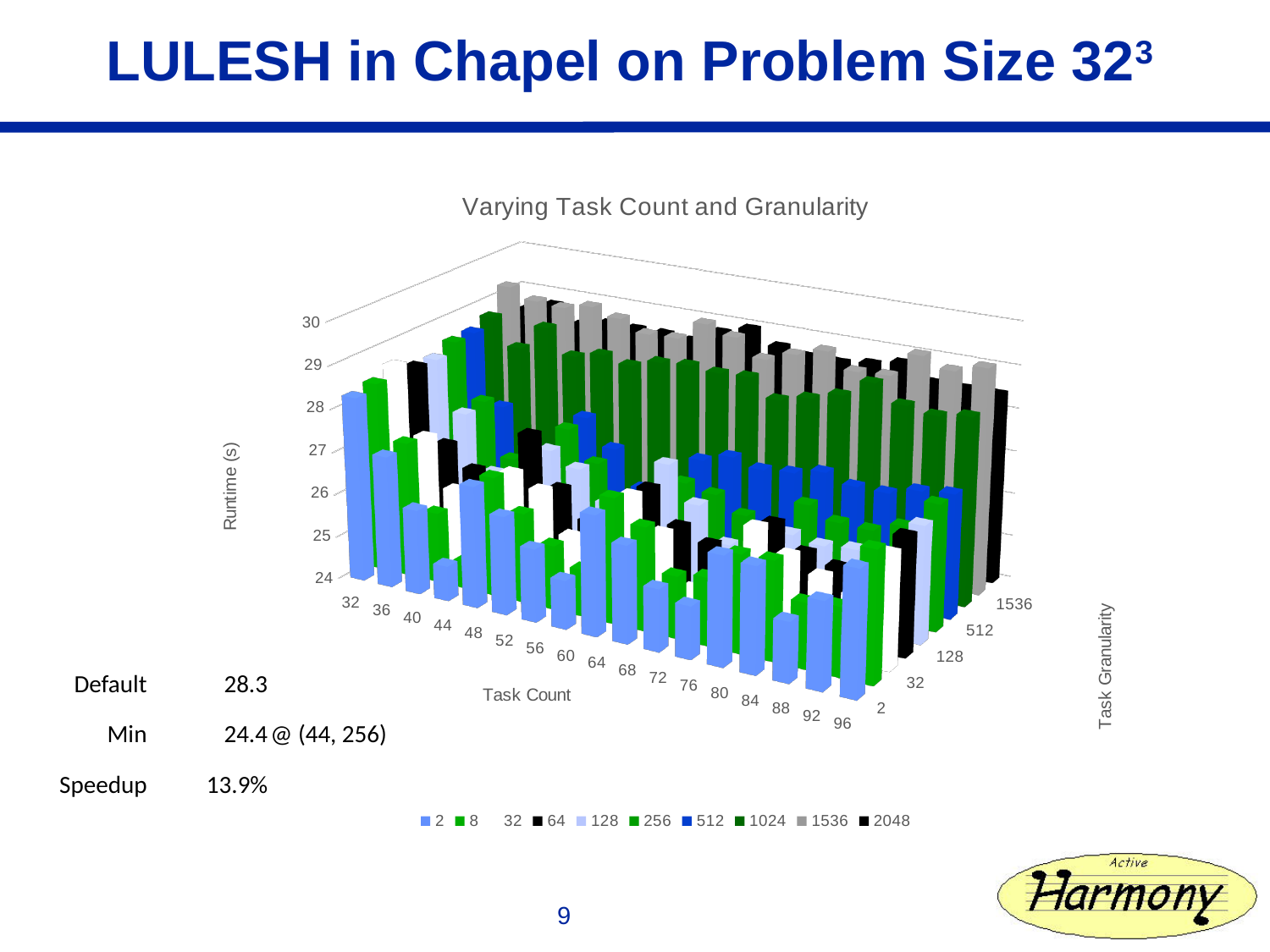
At which (task count, granularity) setting does the slide report the minimum runtime? (44, 256) What kind of chart is shown on the slide? bar chart Is the runtime for task count 32 with granularity 2 greater or less than 27? greater What is the minimum runtime reported on the slide? 24.4 How many task count categories are shown along the x axis? 17 What default runtime is listed on the slide? 28.3 What is the title of the chart? Varying Task Count and Granularity How many task granularity series does the legend list? 10 What is the label of the vertical axis? Runtime (s)